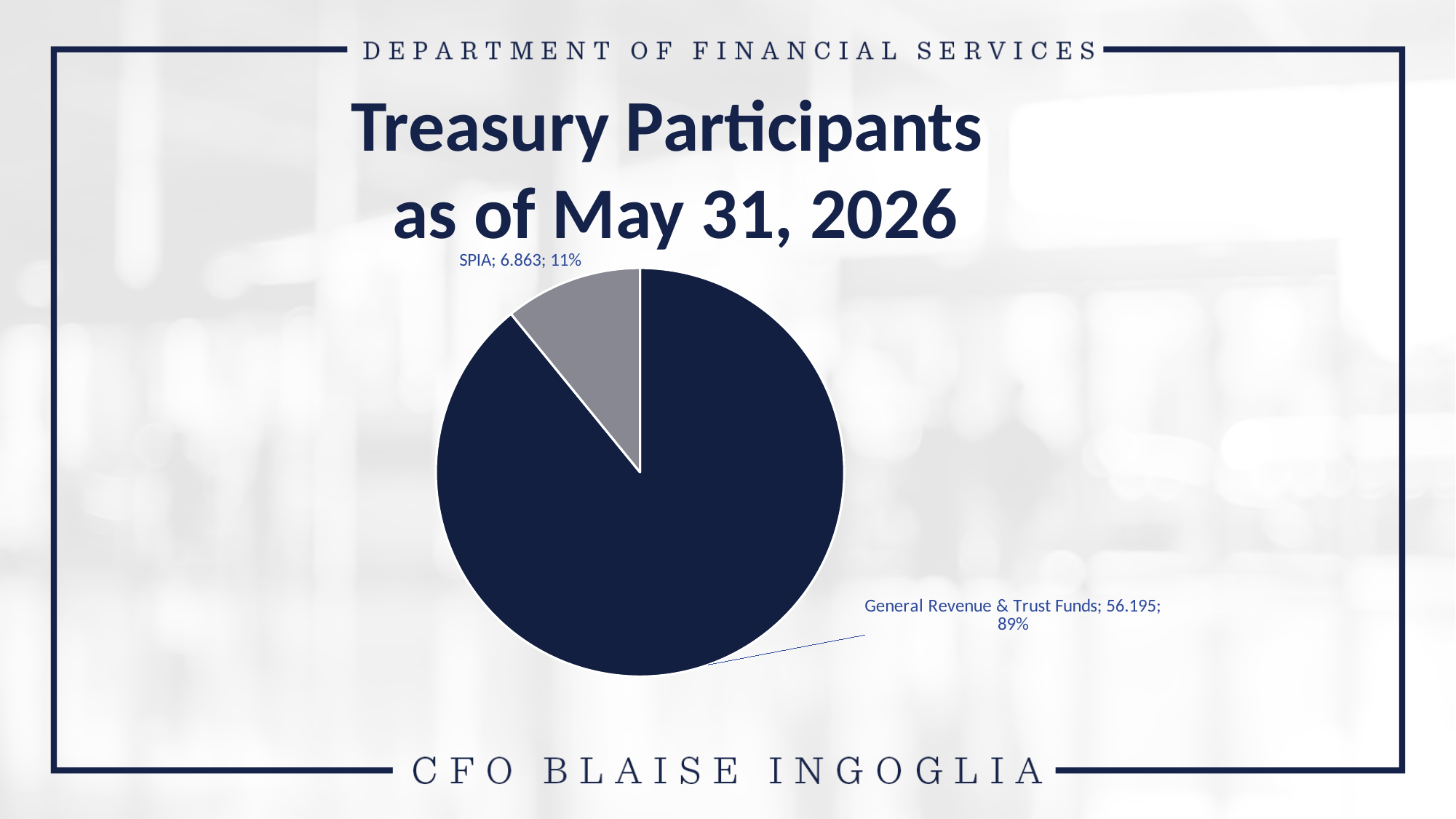
Which category has the largest slice of the pie? General Revenue & Trust Funds What is the title of the chart? Treasury Participants as of May 31, 2026 What is the value for General Revenue & Trust Funds? 56.195 What kind of chart is shown on the slide? Pie chart What colour is the SPIA slice of the pie? Grey Which is larger, the value for SPIA or the value for General Revenue & Trust Funds? General Revenue & Trust Funds How many categories are shown in the pie chart? 2 What share of the pie does General Revenue & Trust Funds represent? 89% What is the difference between the value for General Revenue & Trust Funds and the value for SPIA? 49.332 Which category has the smallest slice of the pie? SPIA What share of the pie does SPIA represent? 11% What is the value for SPIA? 6.863